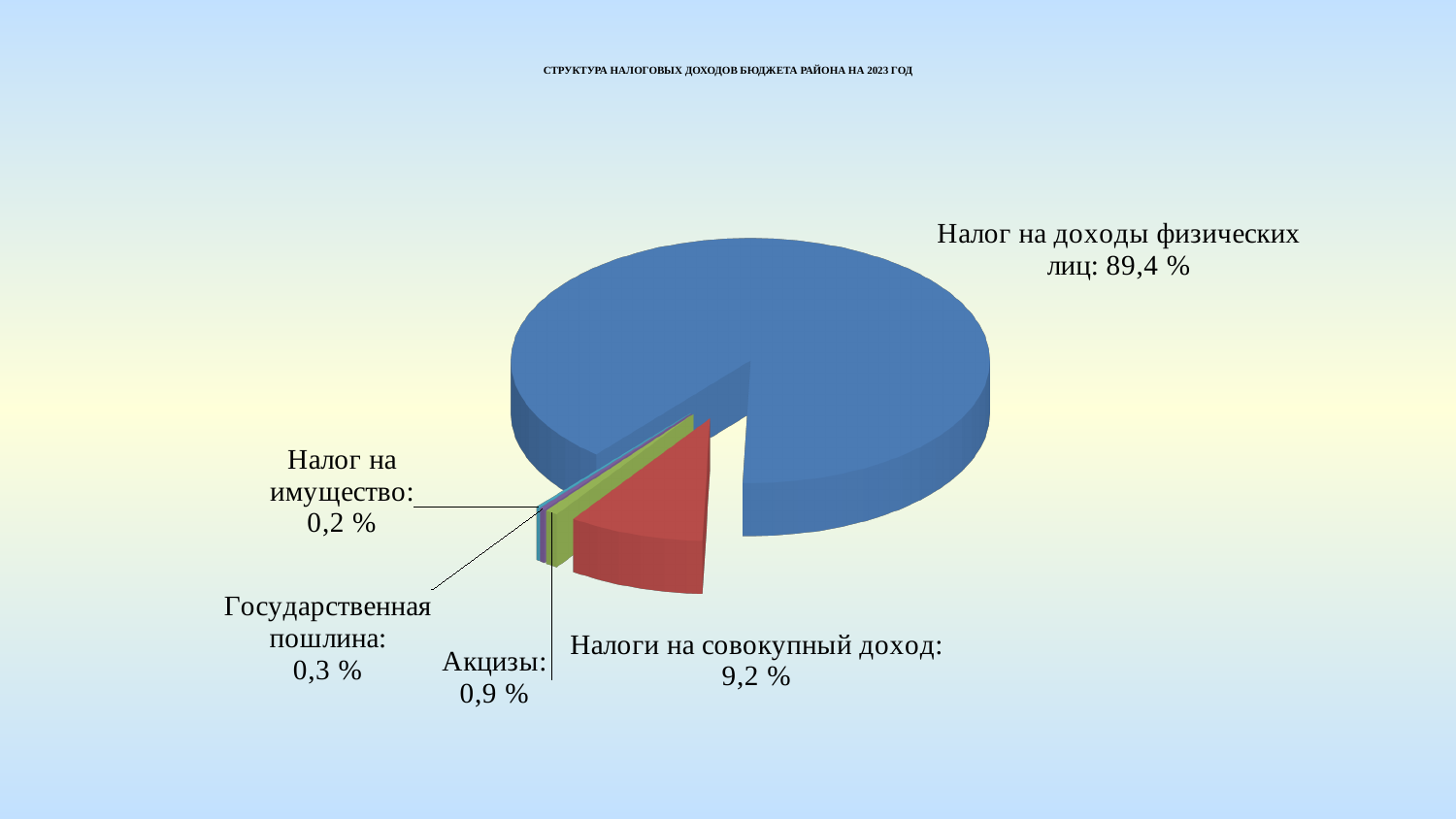
What is the title of the chart on the slide? СТРУКТУРА НАЛОГОВЫХ ДОХОДОВ БЮДЖЕТА РАЙОНА НА 2023 ГОД Which category has the smallest slice of the pie? Налог на имущество What is the value shown for "Налог на имущество"? 0,2 % How many slices does the pie chart have? 5 What is the value shown for "Акцизы"? 0,9 % Which is larger: the value for "Акцизы" or the value for "Государственная пошлина"? Акцизы What kind of chart is shown on the slide? Pie chart What is the value shown for "Государственная пошлина"? 0,3 % What is the value shown for "Налоги на совокупный доход"? 9,2 % Which category has the largest slice of the pie? Налог на доходы физических лиц What share of the pie does "Налог на доходы физических лиц" have? 89,4 % What is the difference between the values for "Налог на доходы физических лиц" and "Налоги на совокупный доход"? 80,2 %